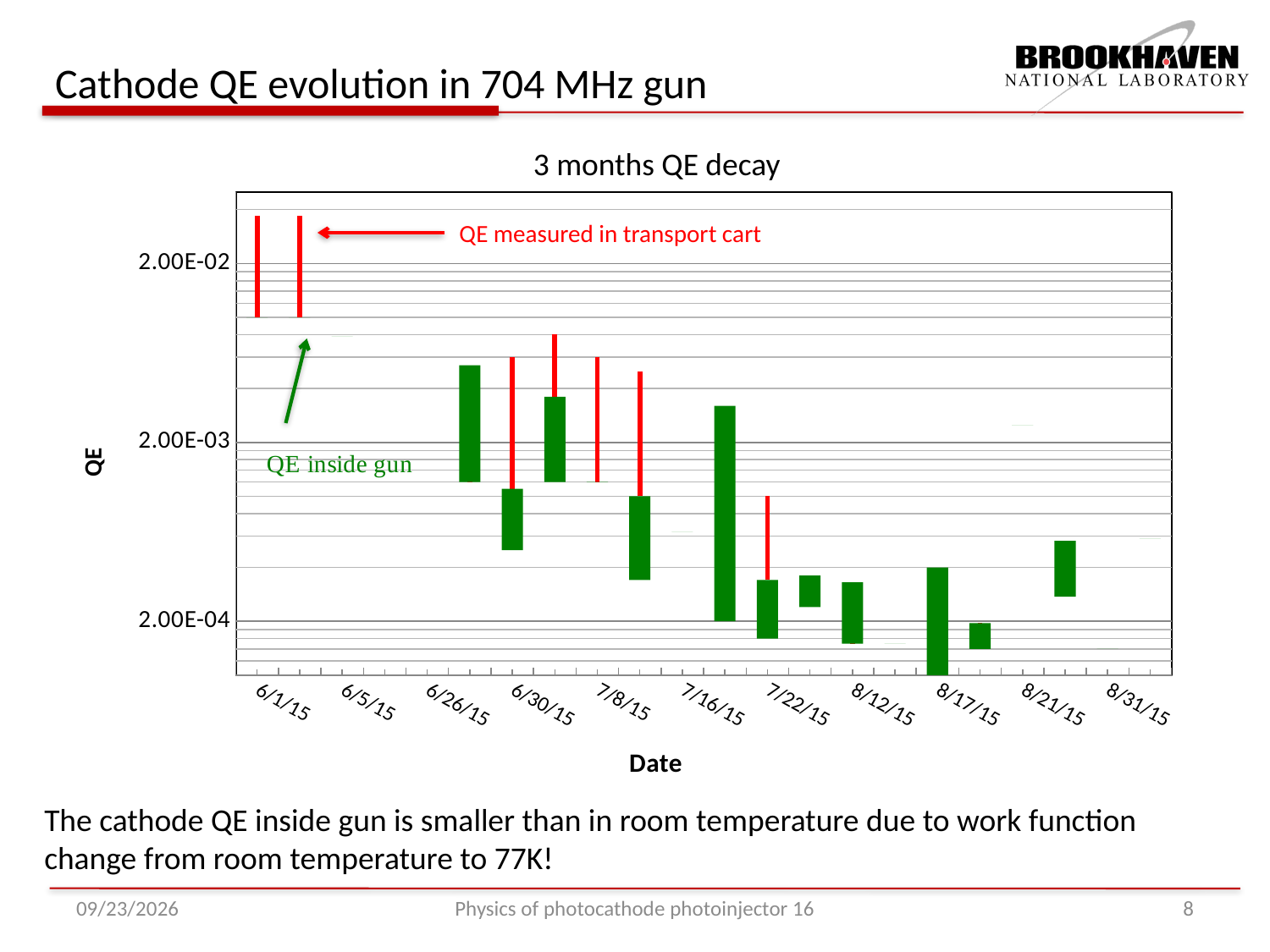
What is the first date label on the x axis of the chart? 6/1/15 Overall, do the QE values rise or fall from June to August along the x axis? fall Is the QE inside the gun near 8/21/15 greater or less than 2.00E-03? less What kind of chart is shown on the slide? bar chart What is the title of the chart? 3 months QE decay What is the label of the x axis of the chart? Date What is the label of the y axis of the chart? QE What is the lowest tick value printed on the y axis of the chart? 2.00E-04 How many date labels are shown along the x axis of the chart? 11 What is the highest tick value printed on the y axis of the chart? 2.00E-02 What is the last date label on the x axis of the chart? 8/31/15 Is the QE measured in the transport cart near 6/1/15 greater or less than 2.00E-03? greater